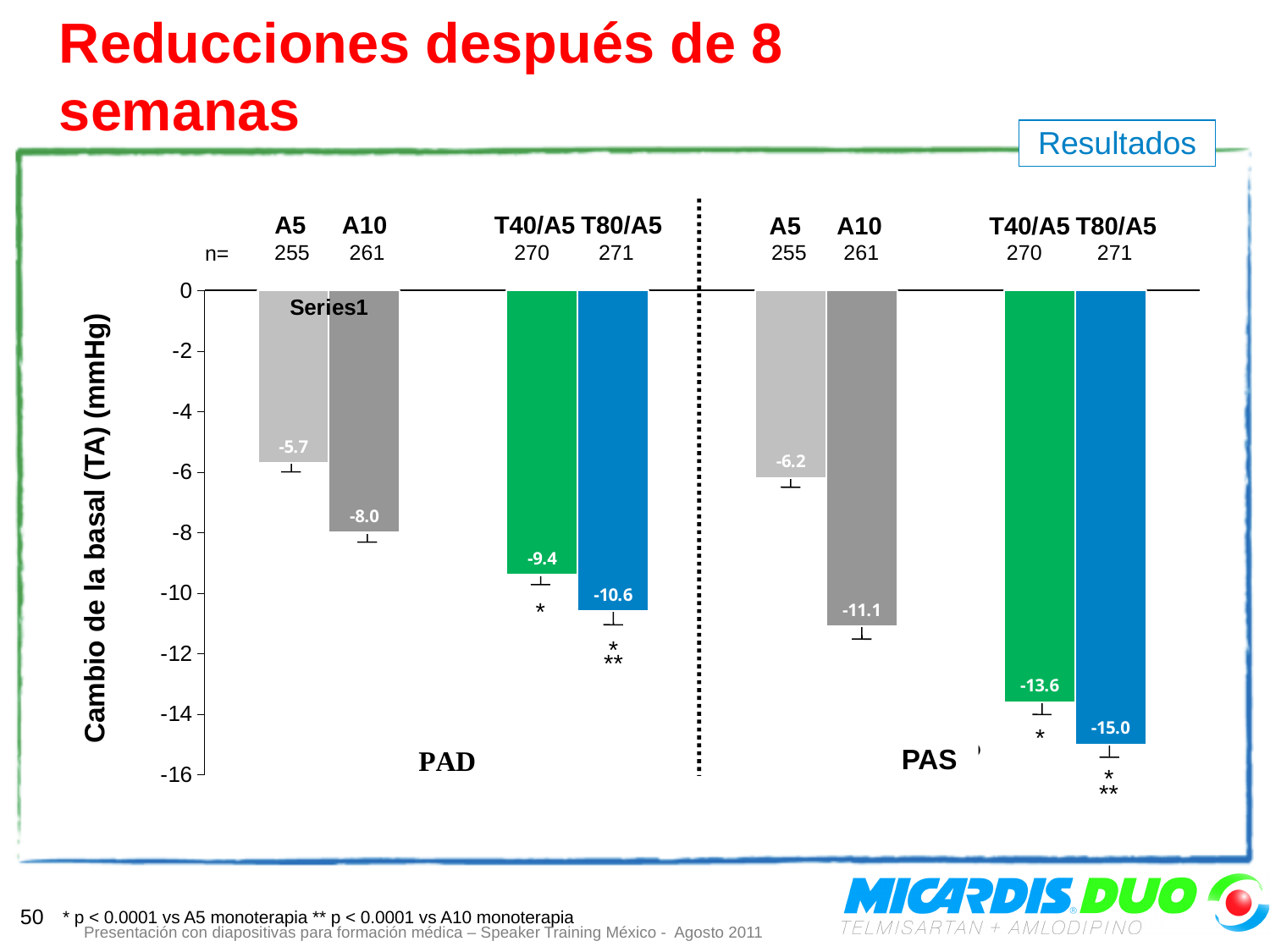
What is the value for T40/A5 in the PAD group? -9.4 What is the value for A5 in the PAD group? -5.7 What is the value for T80/A5 in the PAS group? -15.0 What is the y-axis label of the chart? Cambio de la basal (TA) (mmHg) What is the difference between the T40/A5 and A10 values in the PAS group? 2.5 Which bar in the PAD group shows the smallest reduction? A5 Which bar in the PAS group shows the largest reduction? T80/A5 Which shows a larger reduction: A10 in the PAD group or A10 in the PAS group? A10 in the PAS group What is the value for A10 in the PAS group? -11.1 What kind of chart is shown on the slide? Bar chart How many bars are plotted in the chart in total? 8 What is the difference between the T80/A5 and A5 values in the PAD group? 4.9